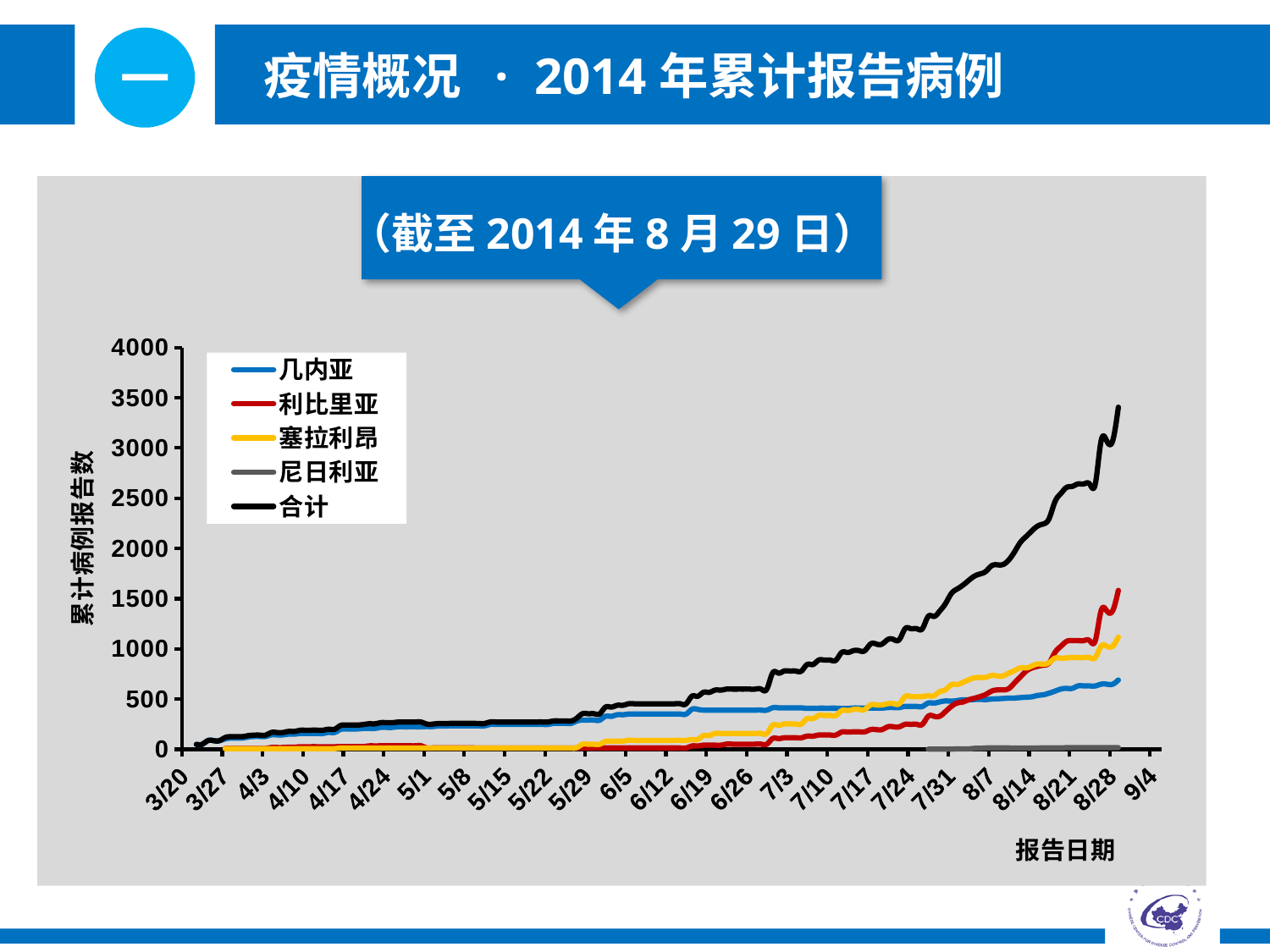
Among the four countries, which has the highest cumulative case count at the end of the chart? 利比里亚 Among the four countries, which has the lowest cumulative case count at the end of the chart? 尼日利亚 What is the label of the y axis? 累计病例报告数 What kind of chart is shown on the slide? line chart Does the 合计 series rise or fall along the x axis? rise How many series does the chart legend list? 5 Around 5/1, which is larger: the value for 几内亚 or the value for 利比里亚? 几内亚 At the end of the chart, which is larger: the value for 利比里亚 or the value for 几内亚? 利比里亚 Is the final value of the 尼日利亚 series greater or less than 500? less Is the final value of the 几内亚 series greater or less than 1000? less Which series has the highest value at the end of the chart (late August)? 合计 Is the final value of the 合计 series greater or less than 3000? greater